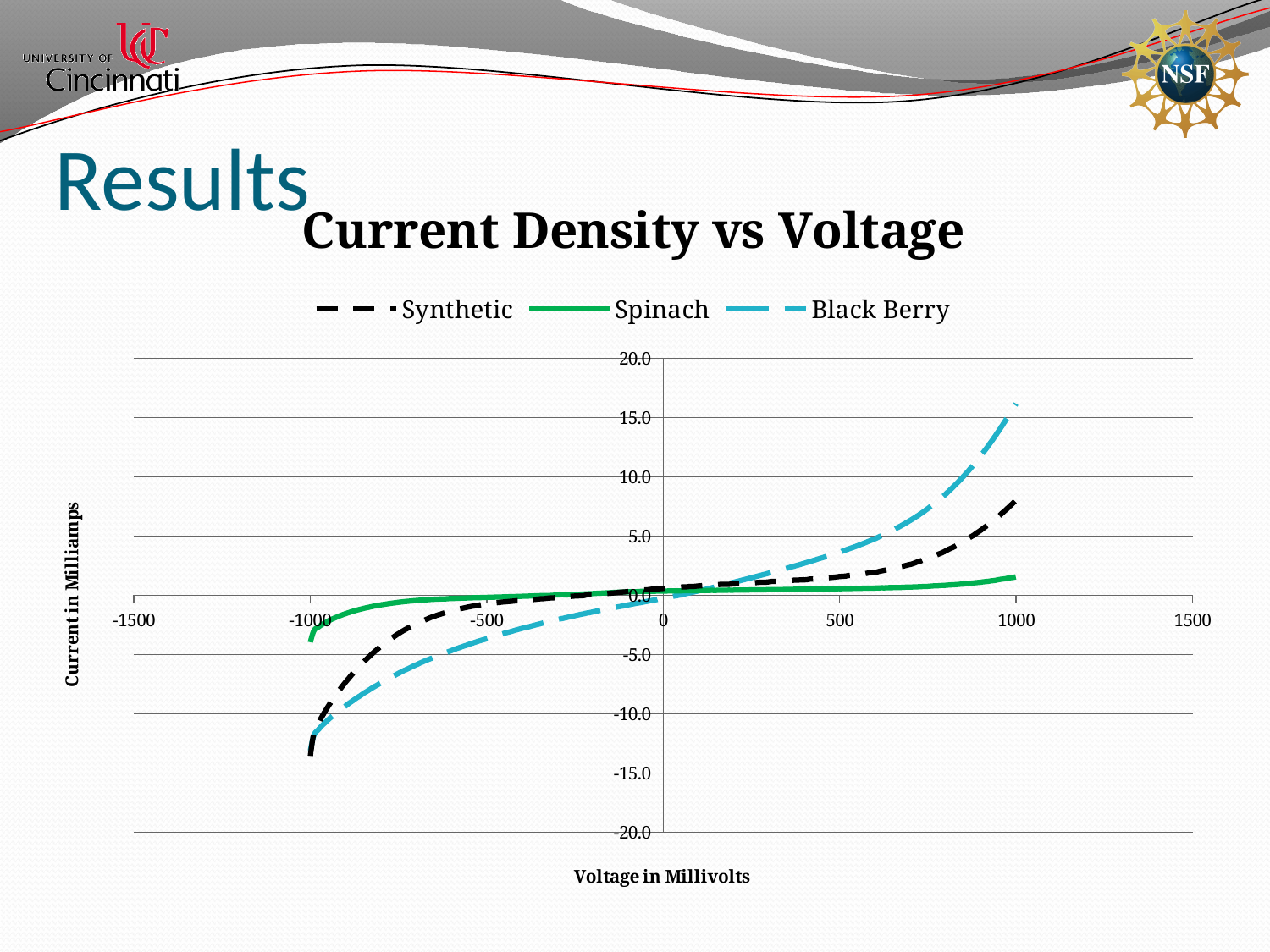
Which series reaches the highest current at 1000 millivolts? Black Berry Does the Black Berry current rise or fall as voltage increases from -1000 to 1000 millivolts? rise What is the label of the vertical axis? Current in Milliamps What is the title of the chart? Current Density vs Voltage How many series does the legend list? 3 What kind of chart is shown on the slide? line chart Is the Black Berry current at 1000 millivolts greater or less than 10.0? greater At 1000 millivolts, which series has the higher current, Black Berry or Synthetic? Black Berry Is the Spinach current at 1000 millivolts greater or less than 5.0? less Is the Spinach current at -1000 millivolts greater or less than -5.0? greater